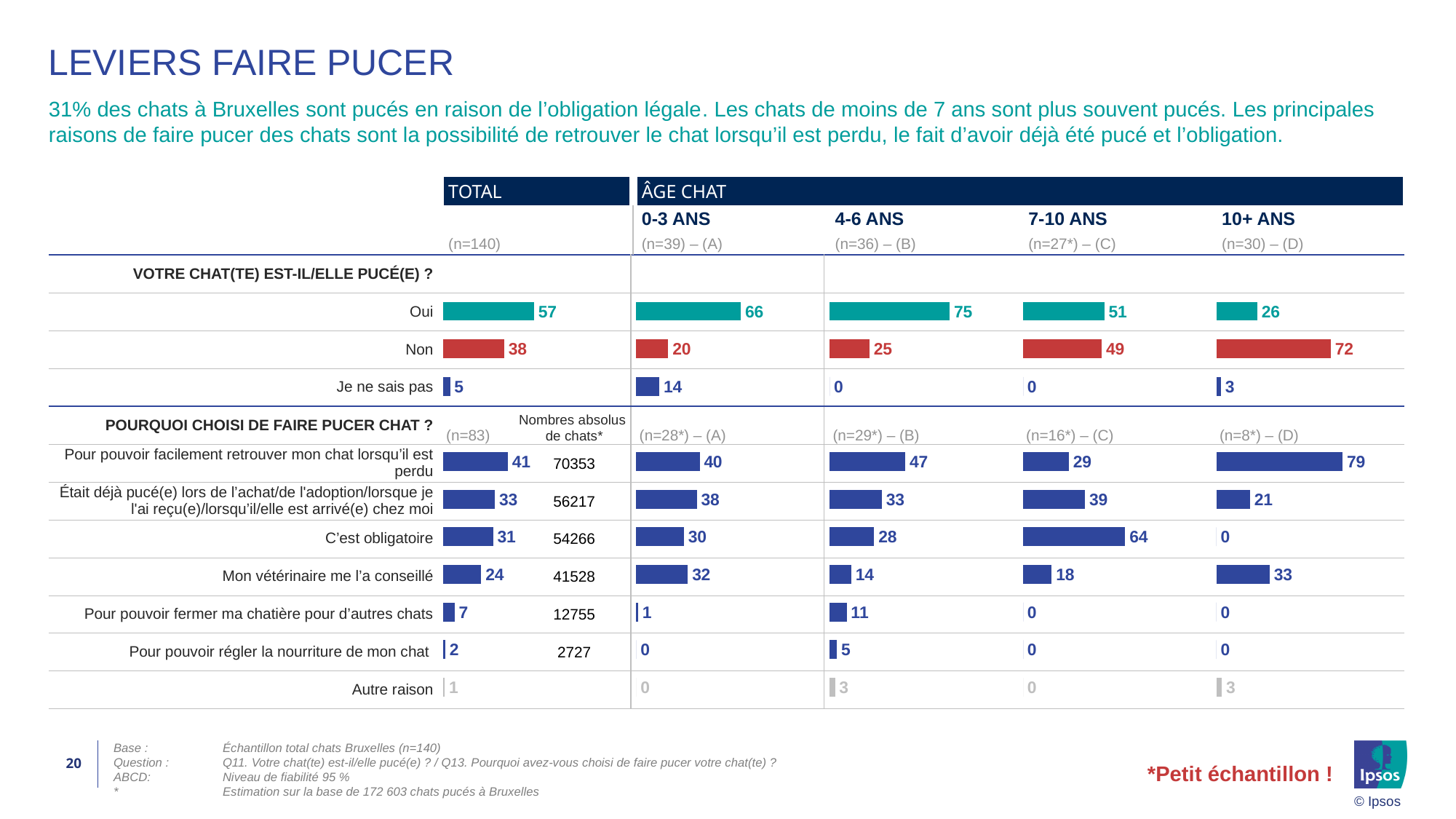
In the 0-3 ANS column, is the value for "Mon vétérinaire me l'a conseillé" larger or smaller than in the 4-6 ANS column? larger What kind of chart is used to display the values in the table? bar chart In the 10+ ANS column, what is the value for "Non"? 72 In the TOTAL column, what is the difference between "Oui" and "Non"? 19 Across the age groups, which has the lowest value for "Oui"? 10+ ANS What is the sample size (n) for the TOTAL column of the question "Votre chat(te) est-il/elle pucé(e) ?"? n=140 How many reasons for having the cat chipped are listed in the "Pourquoi choisi de faire pucer chat ?" section? 7 Across the age groups (0-3, 4-6, 7-10, 10+ ans), which has the highest value for "Oui"? 4-6 ANS In the 7-10 ANS column, what is the value for "C'est obligatoire"? 64 In the TOTAL column, what is the value for "Oui" to the question "Votre chat(te) est-il/elle pucé(e) ?"? 57 What is the absolute number of cats ("Nombres absolus de chats") for "Était déjà pucé(e) lors de l'achat/de l'adoption"? 56217 In the TOTAL column, which reason for having the cat chipped has the highest value? Pour pouvoir facilement retrouver mon chat lorsqu'il est perdu